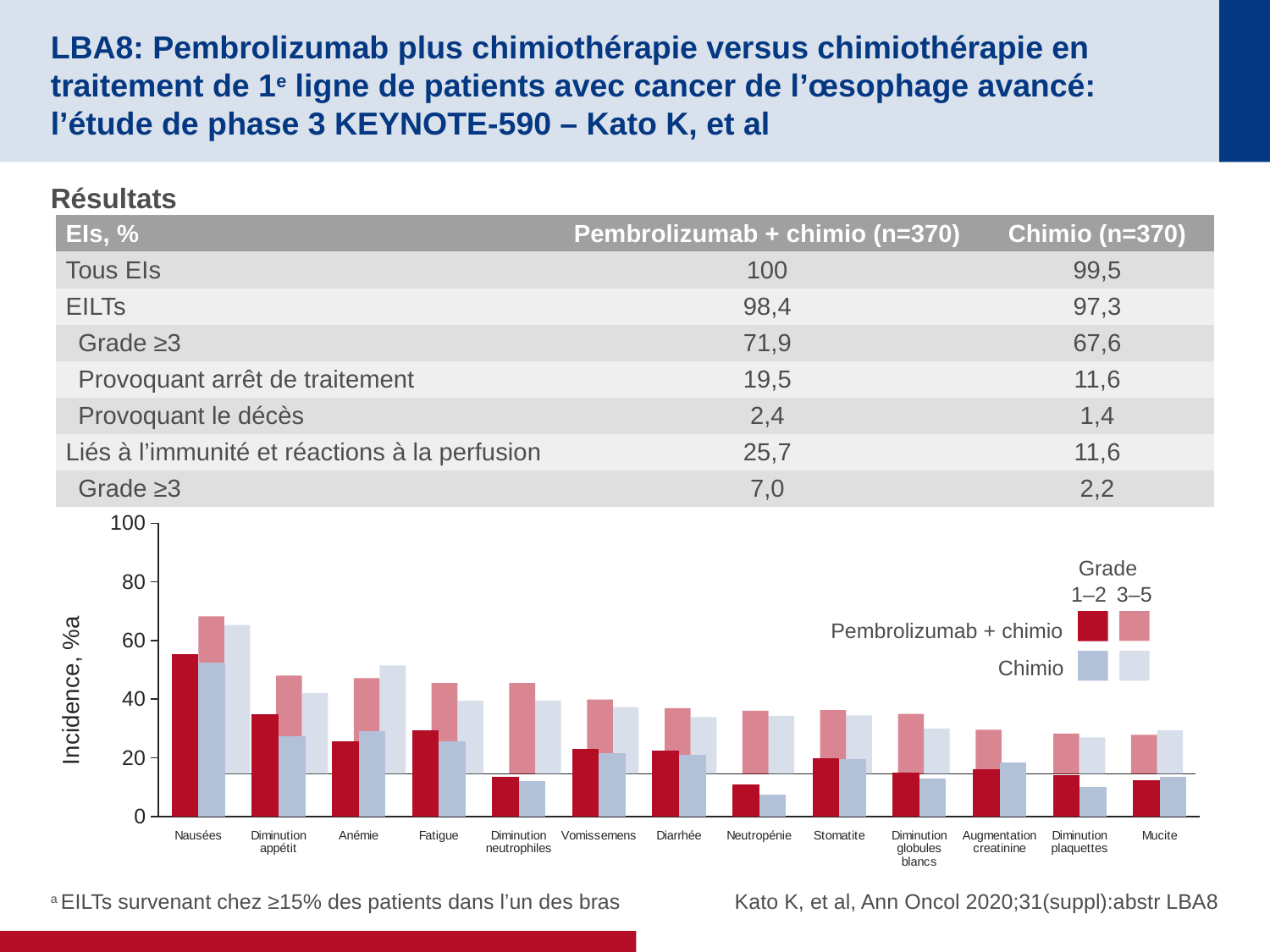
Which is larger in the bar chart: the total incidence of Nausées for Pembrolizumab + chimio or the total incidence of Fatigue for Pembrolizumab + chimio? Nausées for Pembrolizumab + chimio What kind of chart is shown at the bottom of the slide? bar chart Do the Pembrolizumab + chimio incidence values generally rise or fall from left to right along the x axis of the bar chart? fall Which two grade groups does the legend of the bar chart distinguish? 1–2 and 3–5 How many adverse event categories are shown along the x axis of the bar chart? 13 What is the label of the y axis of the bar chart? Incidence, % Which adverse event has the highest incidence for Pembrolizumab + chimio in the bar chart? Nausées How many series does the legend of the bar chart list? 4